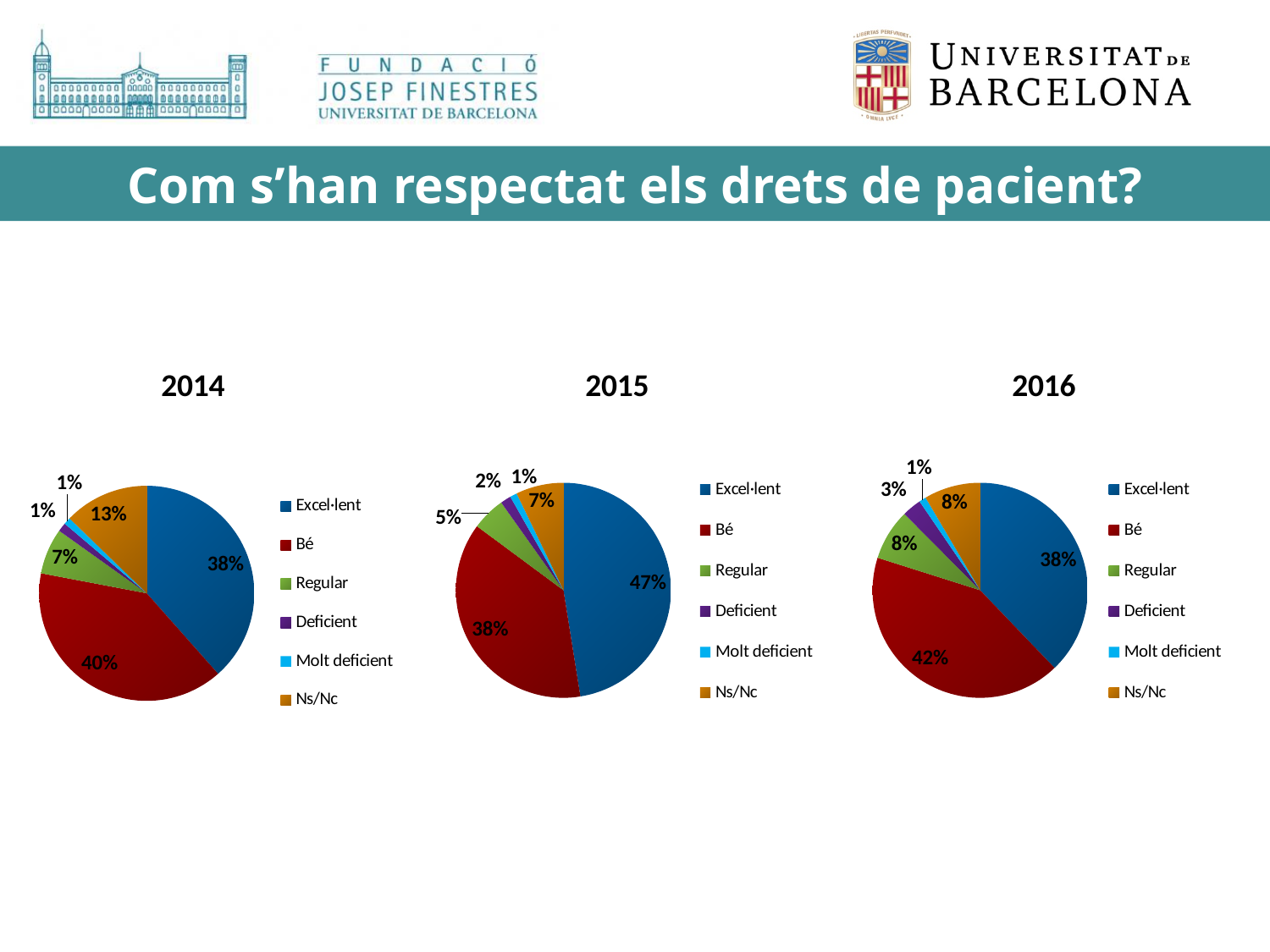
In the 2015 pie chart, what is the difference between the Excel·lent and Bé shares? 9% In the 2015 pie chart, what share is labelled for Regular? 5% In the 2014 pie chart, what share is labelled for Bé? 40% In the 2015 pie chart, what share is labelled for Excel·lent? 47% In the 2016 pie chart, what share is labelled for Bé? 42% In the 2014 pie chart, what share is labelled for Ns/Nc? 13% What type of chart is used for the 2014, 2015 and 2016 data? Pie chart In the 2016 pie chart, what share is labelled for Deficient? 3% In the 2014 pie chart, which is larger, the Bé slice or the Excel·lent slice? Bé In the 2016 pie chart, which category has the smallest slice? Molt deficient In the 2015 pie chart, which category has the largest slice? Excel·lent How many categories does the legend of the 2016 pie chart list? 6